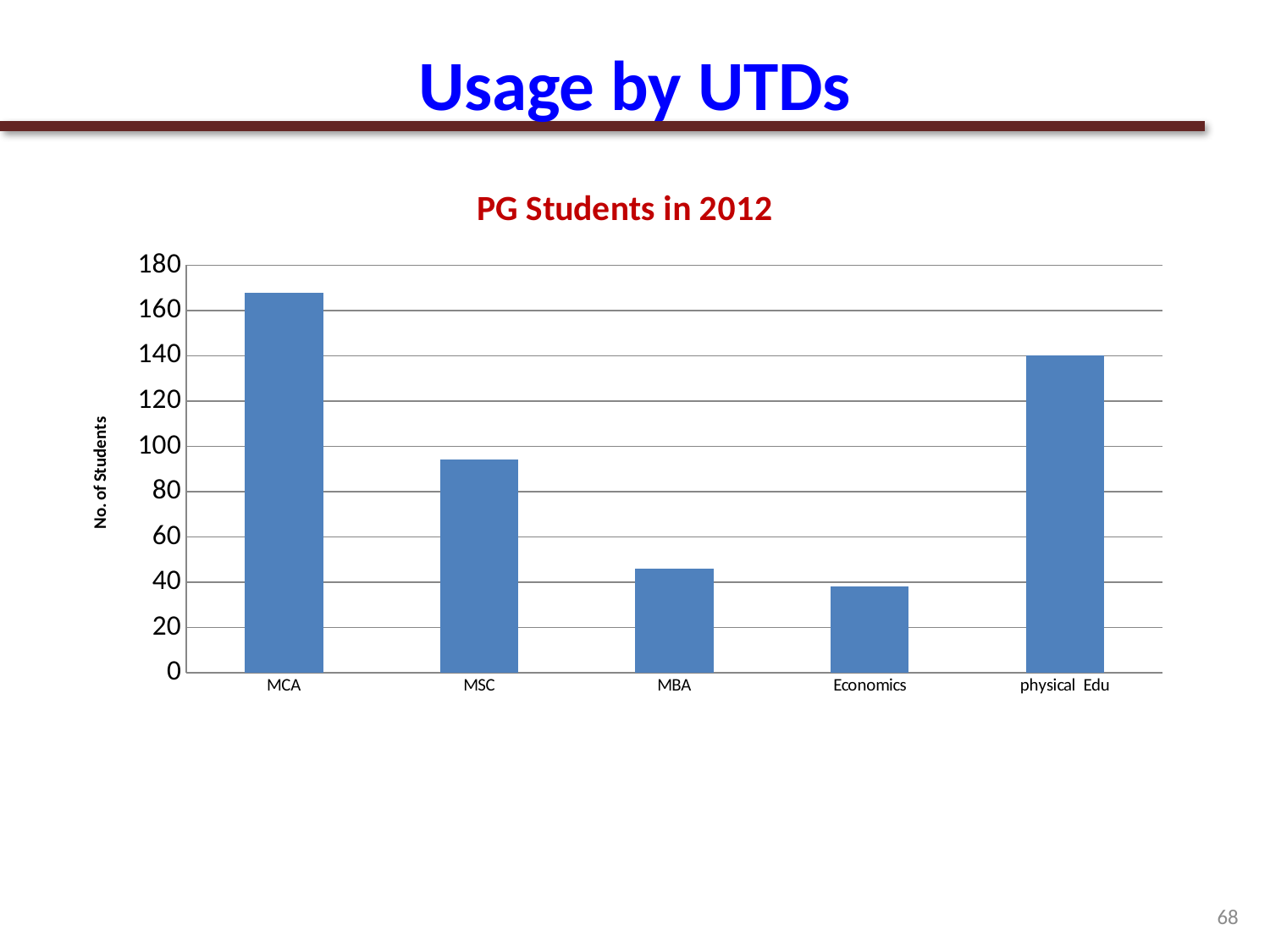
What is the number of students for physical Edu? 140 What type of chart is shown on the slide? Bar chart Which category has the highest number of students? MCA What is the label on the vertical axis of the chart? No. of Students Is the value for MCA greater or less than 160? greater Is the value for MSC greater or less than 100? less Which has more students, MBA or Economics? MBA What is the title of the chart? PG Students in 2012 Which has more students, MCA or physical Edu? MCA How many categories are shown on the x axis of the chart? 5 Which category has the lowest number of students? Economics